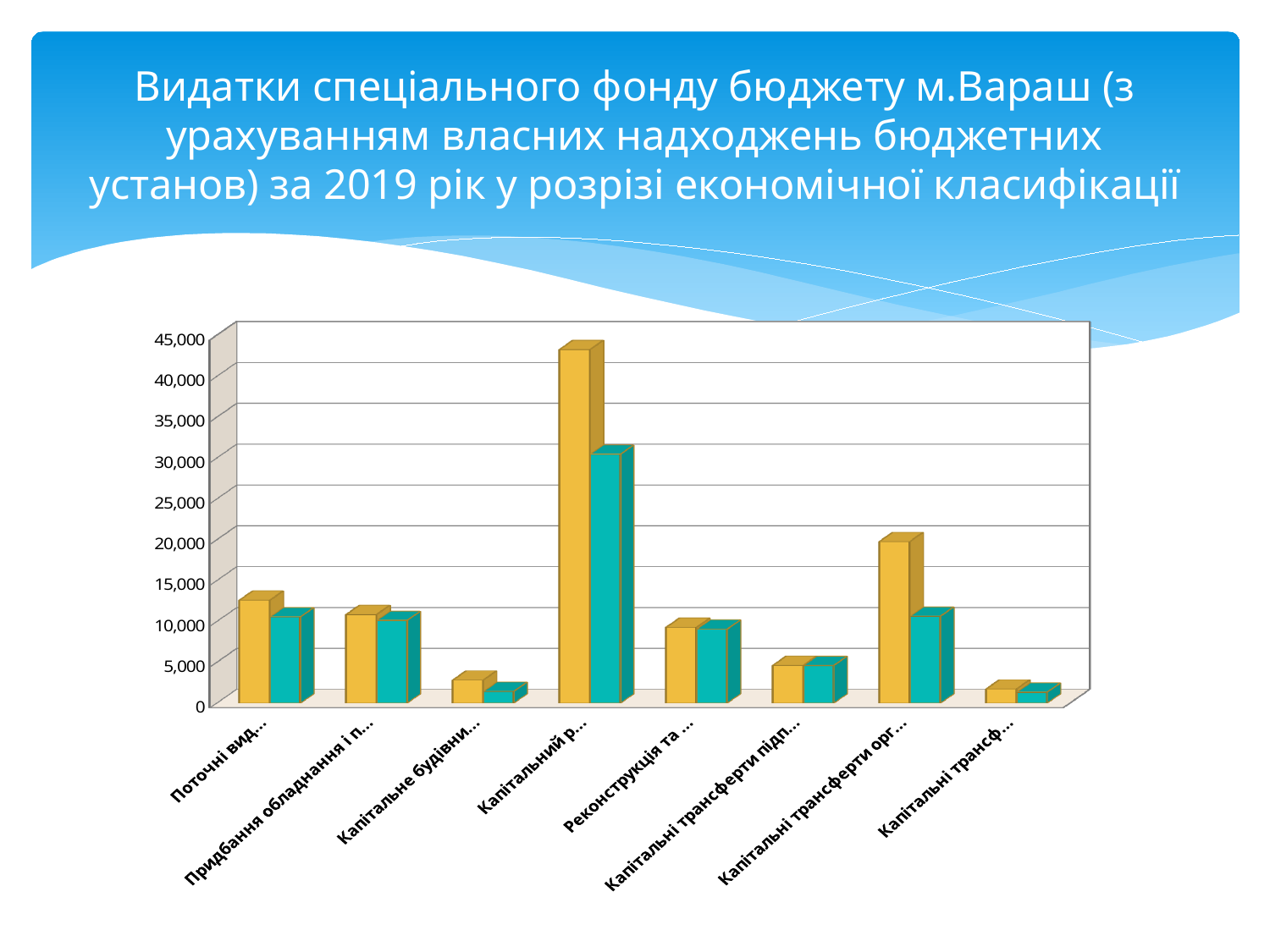
Which category has the highest gold bar in the chart? Капітальний р... Is the gold bar for "Капітальні трансферти орг..." greater or less than 15,000? greater Which category has the highest teal bar in the chart? Капітальний р... What kind of chart is shown on the slide? bar chart Is the gold bar for "Капітальний р..." greater or less than 40,000? greater Is the teal bar for "Капітальне будівни..." greater or less than 5,000? less Which gold bar is larger: "Поточні вид..." or "Капітальні трансферти орг..."? Капітальні трансферти орг... How many categories are shown along the x axis of the chart? 8 What two colours are used for the bars in the chart? gold and teal For "Капітальні трансферти орг...", which bar is larger, the gold one or the teal one? the gold one